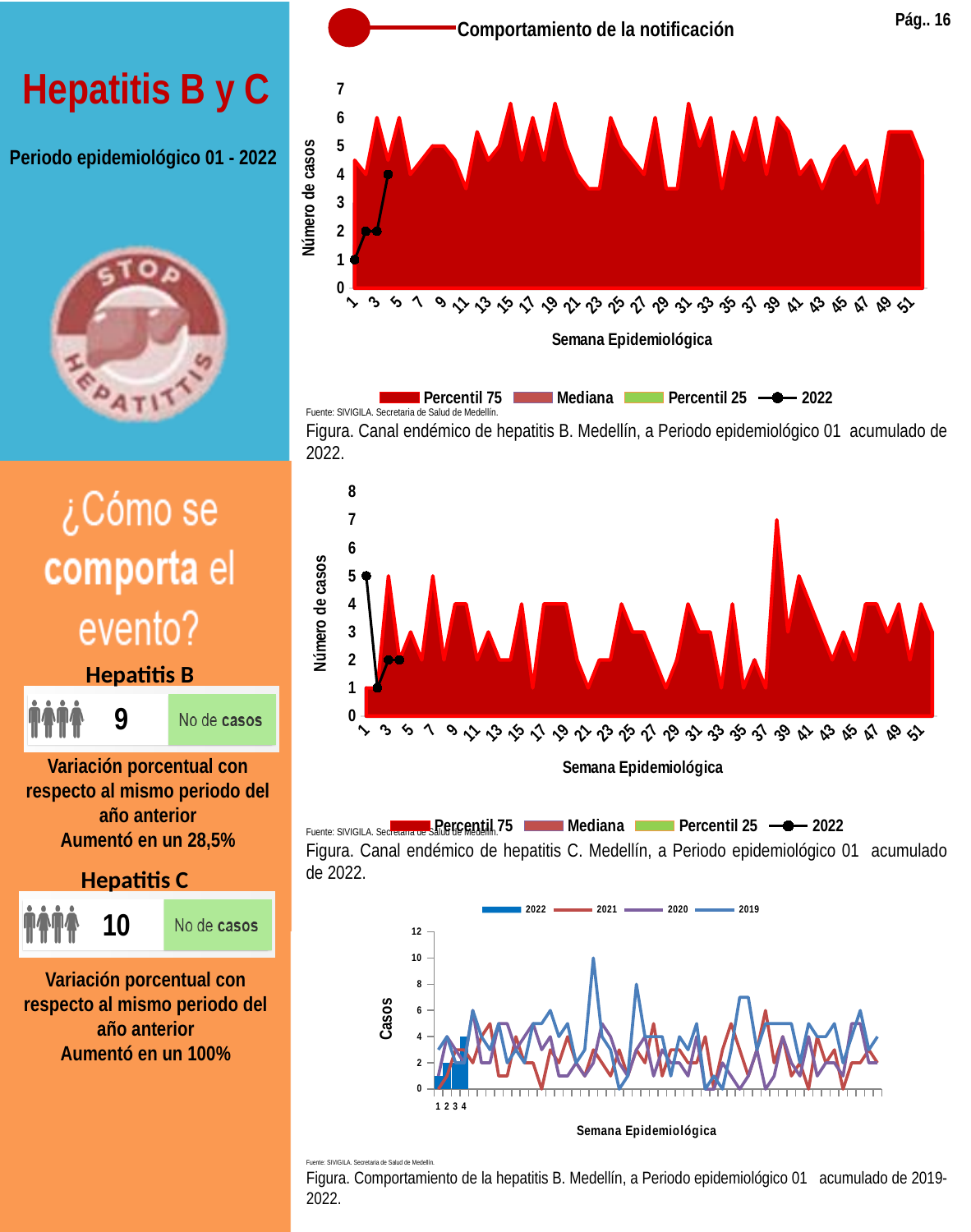
In the hepatitis B endemic channel chart (top), does the 2022 line rise or fall from week 1 to week 4? Rises In the hepatitis C endemic channel chart (middle), is the highest value of the Percentil 75 area greater or less than 6? greater In the hepatitis B endemic channel chart (top), how many points does the 2022 line have? 4 In the hepatitis B endemic channel chart (top), what is the value of the 2022 line at week 4? 4 In the hepatitis B endemic channel chart (top), how many series does the legend list? 4 In the hepatitis B endemic channel chart (top), at which week is the 2022 line highest? Week 4 In the bottom chart (Comportamiento de la hepatitis B 2019-2022), how many series does the legend list? 4 In the hepatitis C endemic channel chart (middle), what is the difference between the 2022 values at week 1 and week 2? 4 In the hepatitis C endemic channel chart (middle), is the 2022 value at week 1 larger than at week 3? Yes In the hepatitis C endemic channel chart (middle), what is the value of the 2022 line at week 1? 5 In the hepatitis B endemic channel chart (top), what is the value of the 2022 line at week 1? 1 In the hepatitis C endemic channel chart (middle), at which week is the 2022 line lowest? Week 2